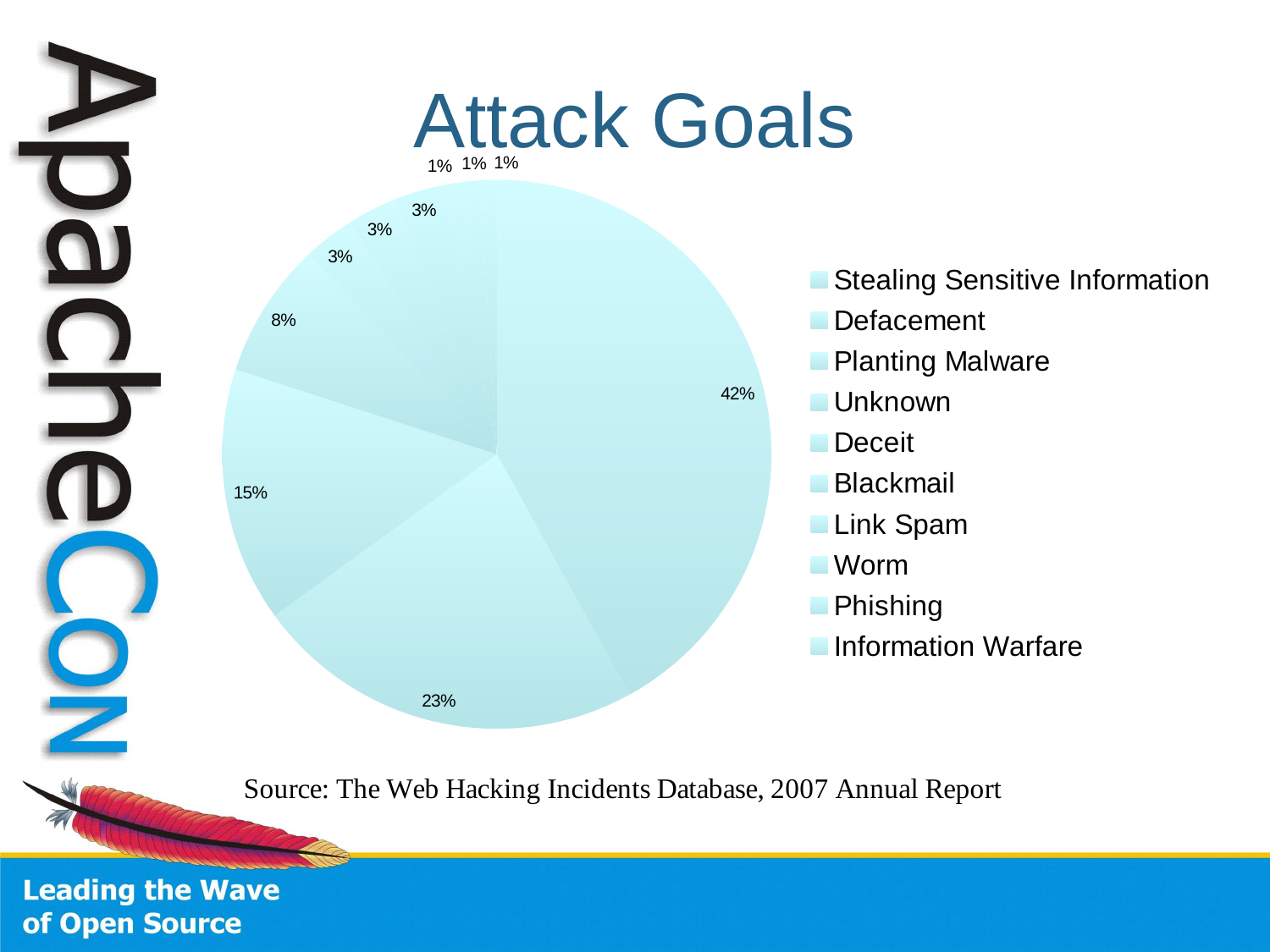
What kind of chart is shown on the slide? pie chart What is the share of the second-largest slice in the pie? 23% Which legend entry is listed first? Stealing Sensitive Information How many categories does the legend list? 10 Which is larger, the 15% slice or the 8% slice? the 15% slice What is the share of the largest slice in the pie? 42% What is the combined share of the 15% and 8% slices? 23% What is the title of the chart? Attack Goals What is the share of the smallest slices in the pie? 1% How many slices are labelled 1%? 3 What is the difference between the largest slice (42%) and the second-largest slice (23%)? 19% How many slices are labelled 3%? 3